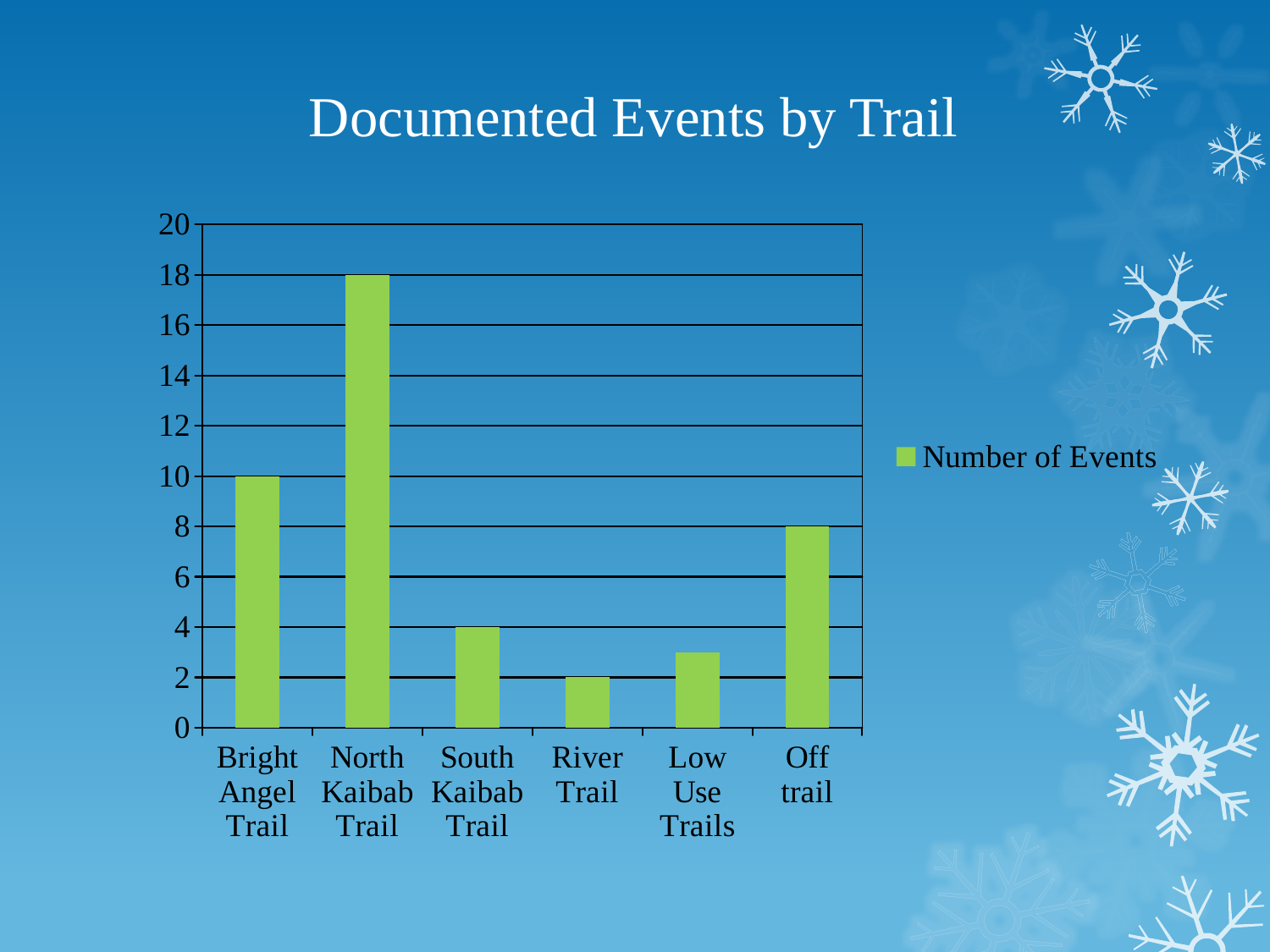
How many trail categories are shown on the x axis? 6 What is the title of the chart? Documented Events by Trail What kind of chart is shown on the slide? Bar chart What is the number of events for Off trail? 8 Is the value for Low Use Trails greater or less than 4? less What is the difference in number of events between North Kaibab Trail and Bright Angel Trail? 8 Which has more events, South Kaibab Trail or Off trail? Off trail Which trail has the highest number of events? North Kaibab Trail Which trail has the lowest number of events? River Trail What is the number of events for Bright Angel Trail? 10 How many series does the legend list? 1 What is the number of events for North Kaibab Trail? 18